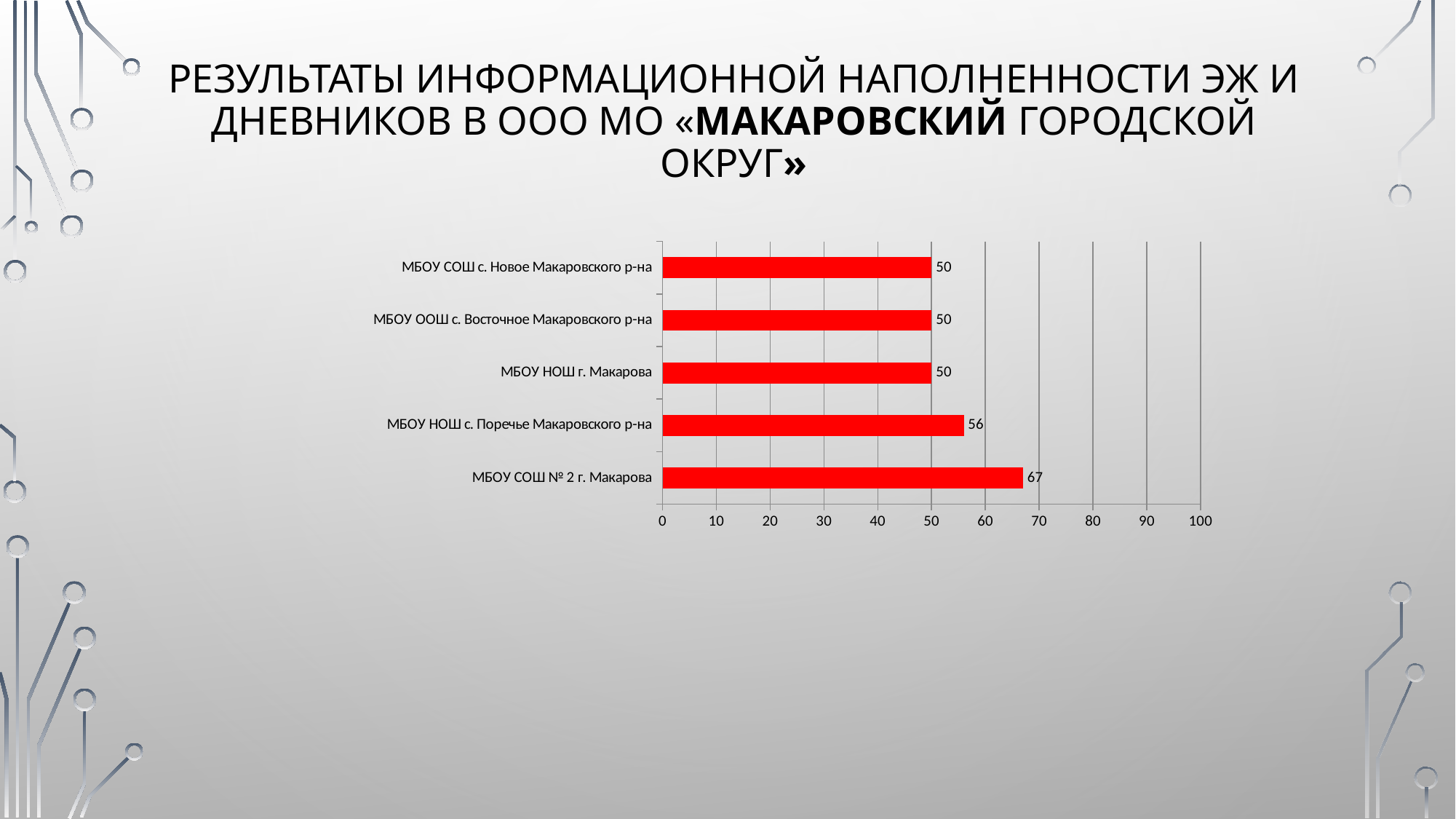
Which category has the highest value? МБОУ СОШ № 2 г. Макарова What is the value for МБОУ НОШ с. Поречье Макаровского р-на? 56 How many categories are shown in the chart? 5 What is the value for МБОУ СОШ № 2 г. Макарова? 67 What is the difference between the values for МБОУ СОШ № 2 г. Макарова and МБОУ НОШ с. Поречье Макаровского р-на? 11 What kind of chart is shown on the slide? bar chart What is the value for МБОУ НОШ г. Макарова? 50 What is the difference between the values for МБОУ НОШ с. Поречье Макаровского р-на and МБОУ ООШ с. Восточное Макаровского р-на? 6 Is the value for МБОУ СОШ № 2 г. Макарова greater or less than 60? greater Which is larger, the value for МБОУ СОШ № 2 г. Макарова or the value for МБОУ НОШ г. Макарова? МБОУ СОШ № 2 г. Макарова What is the value for МБОУ СОШ с. Новое Макаровского р-на? 50 What colour are the bars in the chart? red